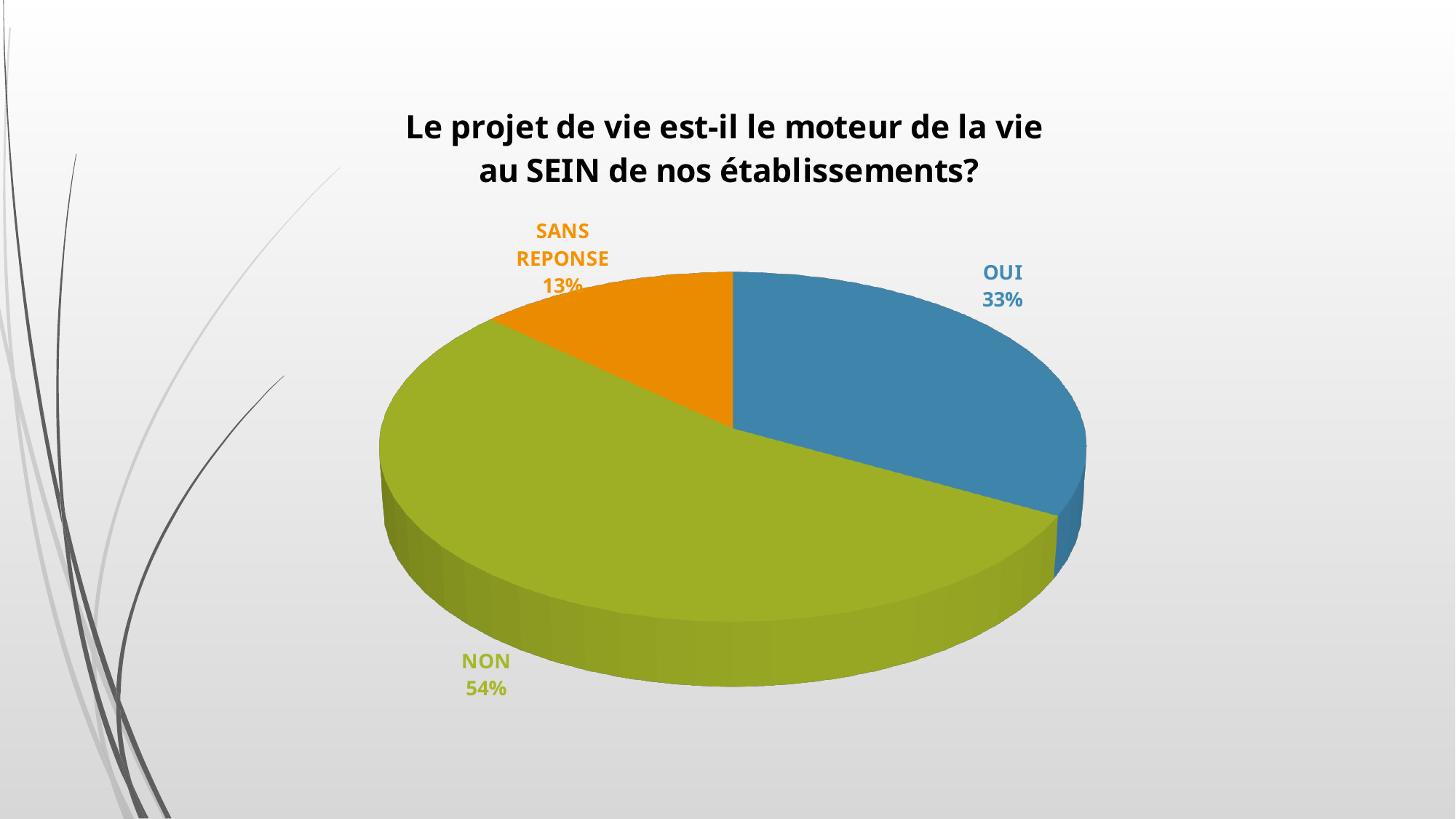
What is the title of the chart? Le projet de vie est-il le moteur de la vie au SEIN de nos établissements? What is the difference in percentage points between NON and OUI? 21 What share of the pie does NON represent? 54% Which category has the smallest slice? SANS REPONSE Which category has the largest slice? NON What share of the pie does SANS REPONSE represent? 13% What colour is the NON slice? Green What is the difference in percentage points between OUI and SANS REPONSE? 20 Which is larger, OUI or SANS REPONSE? OUI What share of the pie does OUI represent? 33% What kind of chart is shown on the slide? Pie chart How many slices does the pie chart have? 3